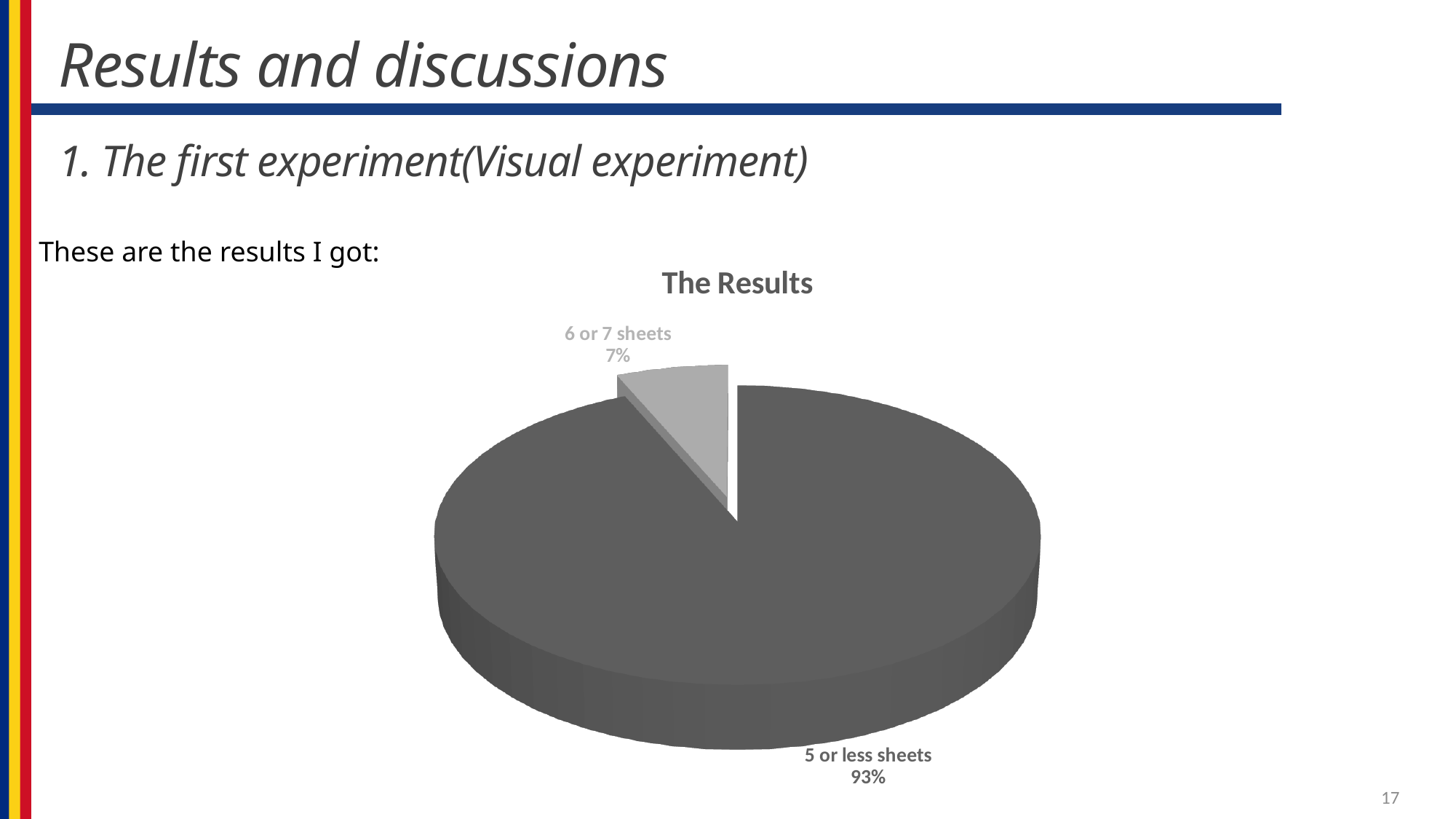
What kind of chart is shown on the slide? pie chart Which slice of the pie is the largest? 5 or less sheets Which slice of the pie is shown in the lighter grey colour? 6 or 7 sheets What share of the pie is labelled "6 or 7 sheets"? 7% What share of the pie is labelled "5 or less sheets"? 93% How many slices does the pie chart have? 2 What is the difference in percentage points between the "5 or less sheets" slice and the "6 or 7 sheets" slice? 86 Which is larger, the "6 or 7 sheets" slice or the "5 or less sheets" slice? 5 or less sheets What is the title of the chart? The Results Which slice of the pie is the smallest? 6 or 7 sheets